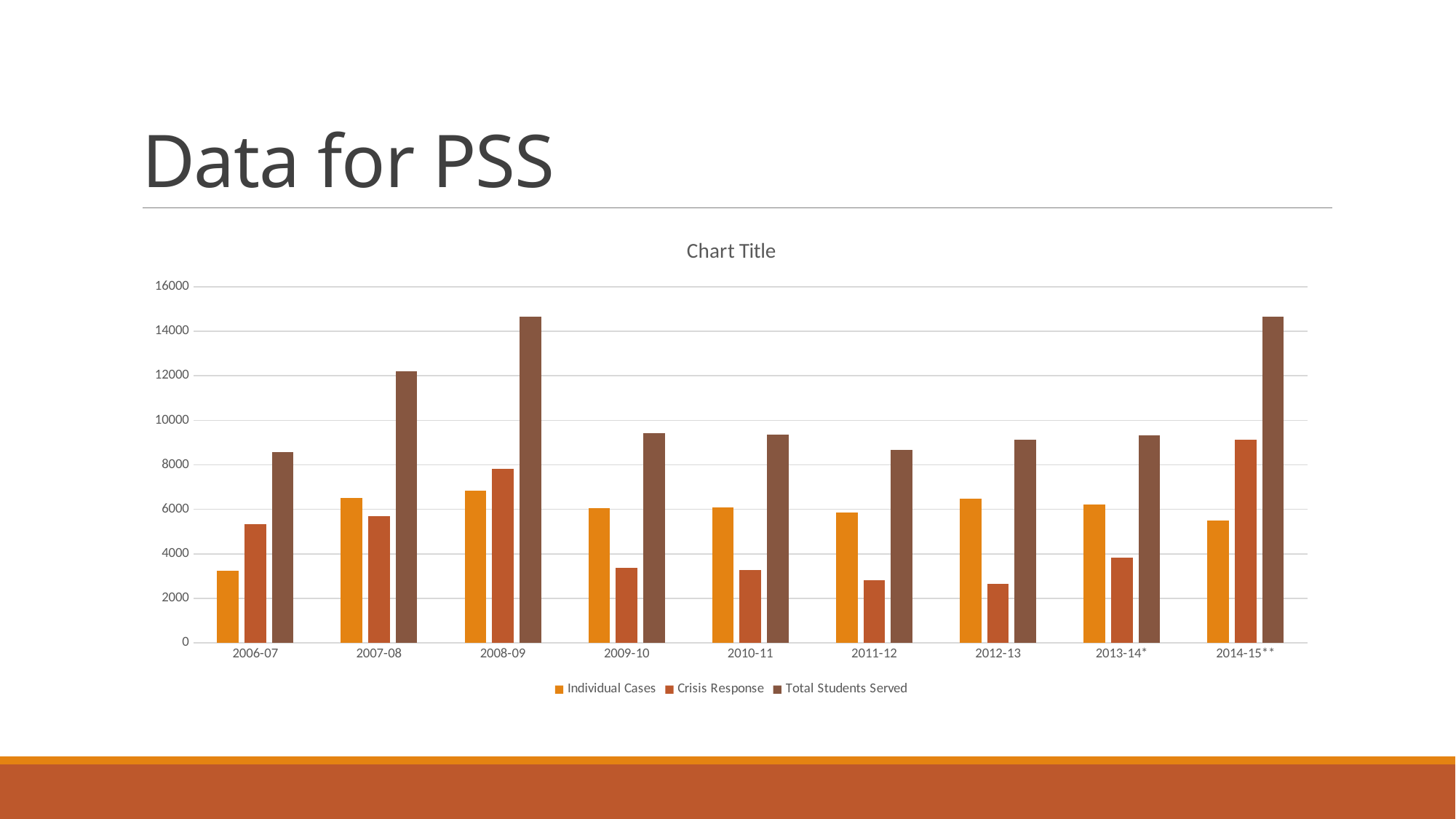
How many series does the legend list? 3 Which school year has the lowest Individual Cases value? 2006-07 In 2014-15**, which is larger: Individual Cases or Crisis Response? Crisis Response Is the Individual Cases value for 2006-07 greater or less than 4000? less In 2007-08, which is larger: Individual Cases or Crisis Response? Individual Cases How many school-year categories are shown on the x axis? 9 Is the Total Students Served value for 2007-08 greater or less than 10000? greater What kind of chart is shown on the slide? bar chart Is the Total Students Served value for 2008-09 greater or less than 14000? greater What is the title shown above the chart? Chart Title Which school year has the highest Crisis Response value? 2014-15**